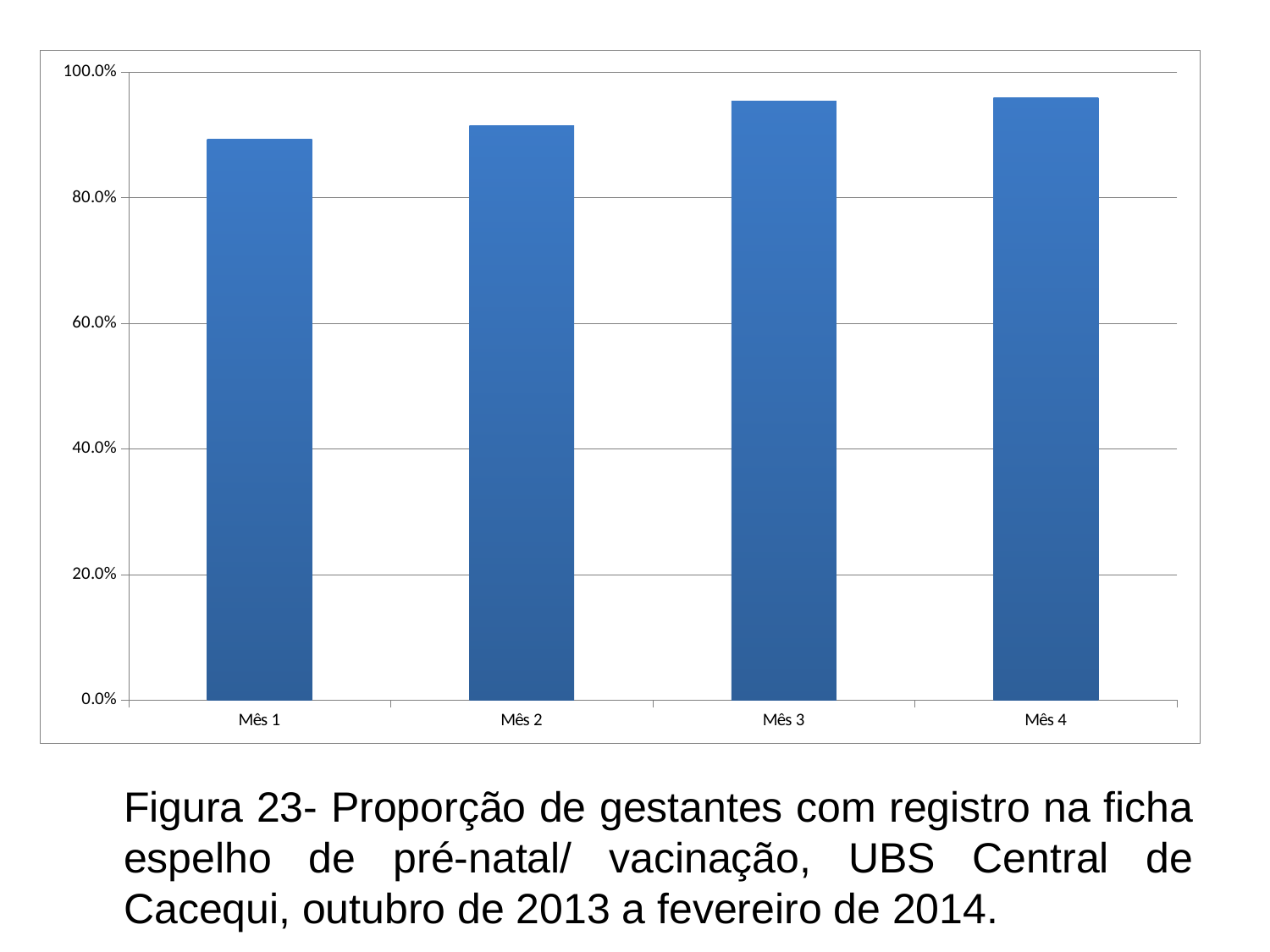
What is the highest value shown on the y axis? 100.0% Which month has the lowest value? Mês 1 Is the value for Mês 1 greater or less than 80.0%? greater Is the value for Mês 3 greater or less than 90.0%? greater Which is larger, the value for Mês 1 or the value for Mês 3? Mês 3 What is the figure number given in the caption below the chart? Figura 23 Which is larger, the value for Mês 2 or the value for Mês 4? Mês 4 How many categories (months) are shown on the x axis? 4 What kind of chart is shown on the slide? bar chart Is the value for Mês 4 greater or less than 100.0%? less Do the values rise or fall from Mês 1 to Mês 4? rise